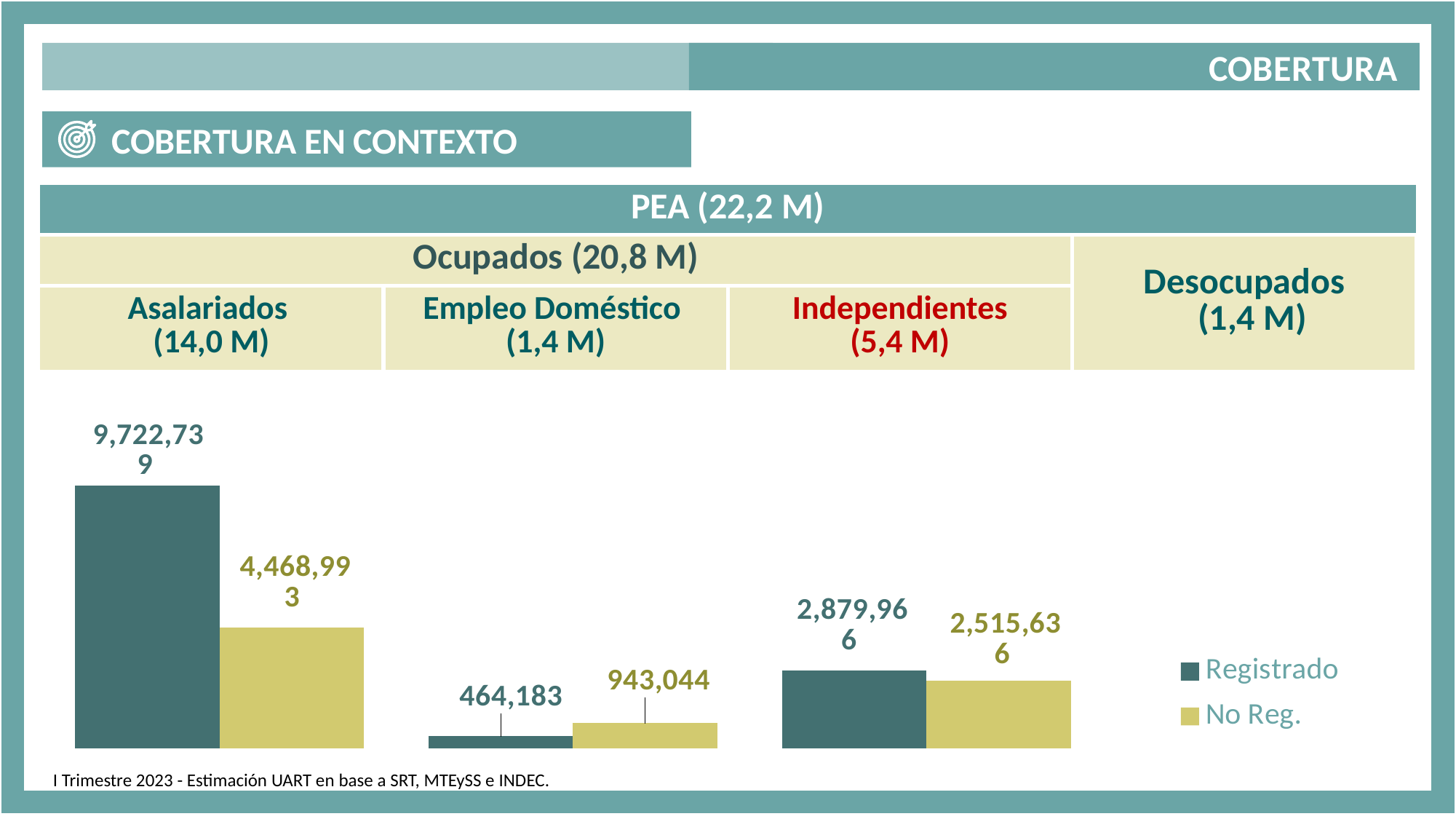
What type of chart is shown on the slide? bar chart What is the Registrado value for Empleo Doméstico? 464,183 What is the No Reg. value for Empleo Doméstico? 943,044 Which group has the highest Registrado value? Asalariados What is the Registrado value for Independientes? 2,879,966 What is the Registrado value for Asalariados? 9,722,739 What is the No Reg. value for Independientes? 2,515,636 For Empleo Doméstico, which is larger: Registrado or No Reg.? No Reg. Which group has the lowest No Reg. value? Empleo Doméstico What is the No Reg. value for Asalariados? 4,468,993 How many series does the chart legend list? 2 What is the difference between the Registrado and No Reg. values for Asalariados? 5,253,746